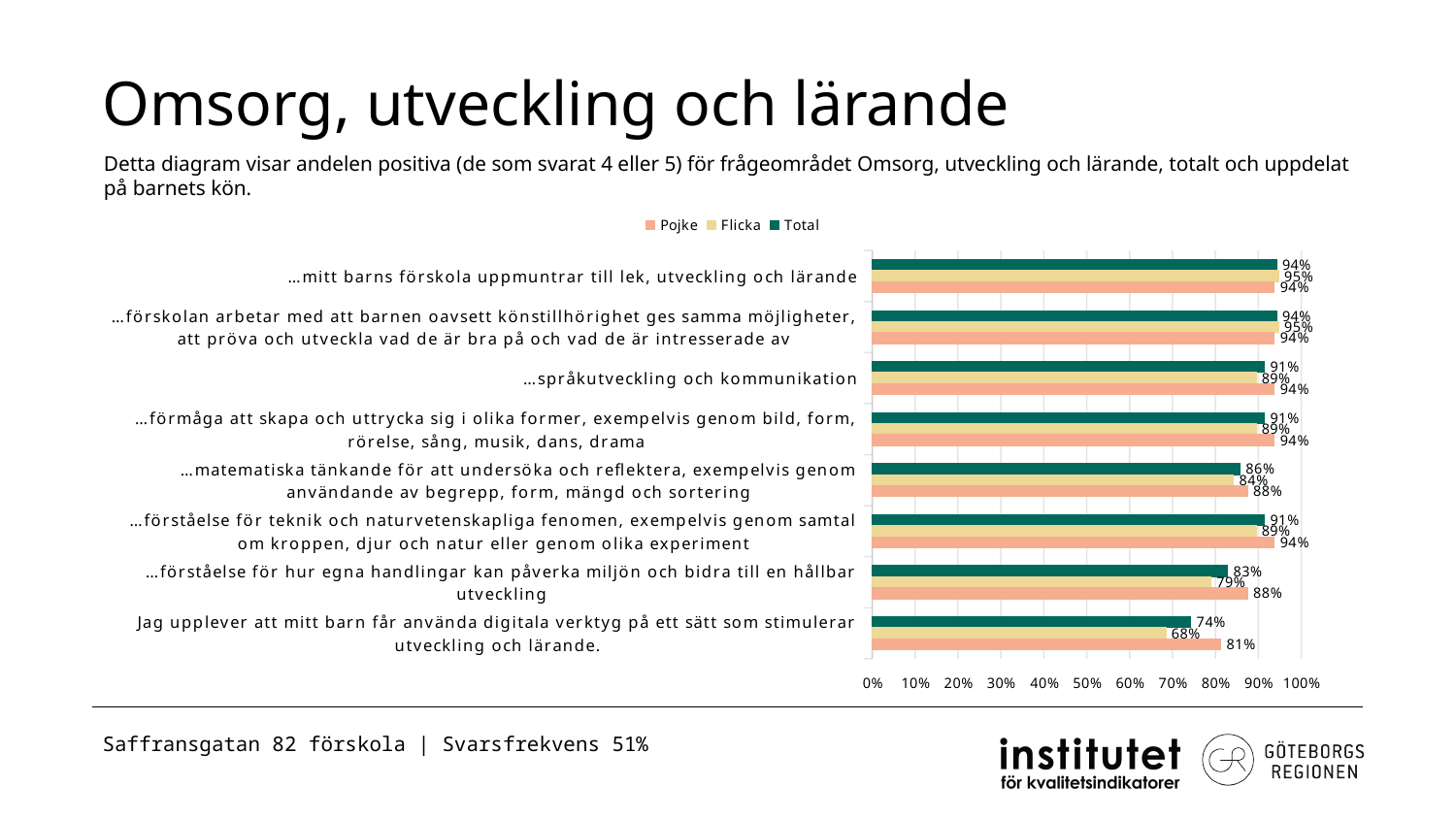
Which series is shown in dark green in the legend? Total What is the difference between the Pojke and Flicka values for "Jag upplever att mitt barn får använda digitala verktyg på ett sätt som stimulerar utveckling och lärande."? 13% What is the Flicka value for "…förståelse för hur egna handlingar kan påverka miljön och bidra till en hållbar utveckling"? 79% What type of chart is shown on the slide? bar chart What is the Total value for "…mitt barns förskola uppmuntrar till lek, utveckling och lärande"? 94% How many categories (statements) are plotted in the chart? 8 Is the Flicka value for "Jag upplever att mitt barn får använda digitala verktyg på ett sätt som stimulerar utveckling och lärande." greater or less than 70%? less How many series does the legend list? 3 For "…språkutveckling och kommunikation", which is larger, the Pojke value or the Flicka value? Pojke What is the Pojke value for "…matematiska tänkande för att undersöka och reflektera, exempelvis genom användande av begrepp, form, mängd och sortering"? 88% Which category has the lowest Total value? Jag upplever att mitt barn får använda digitala verktyg på ett sätt som stimulerar utveckling och lärande. What is the Total value for "Jag upplever att mitt barn får använda digitala verktyg på ett sätt som stimulerar utveckling och lärande."? 74%